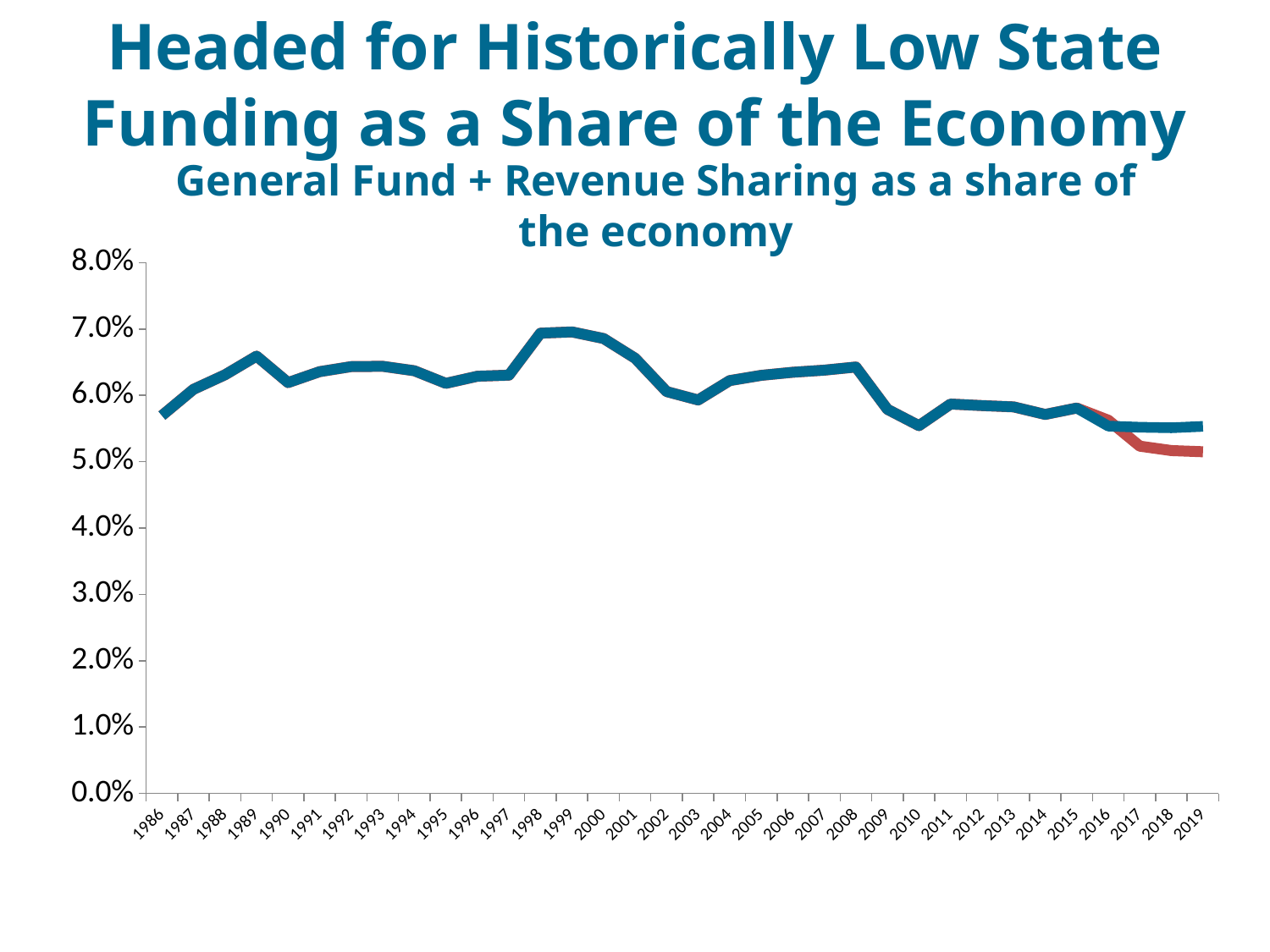
What is the highest tick value shown on the y axis? 8.0% Is the value of the red line for 2019 greater or less than 6.0%? less How many years are labelled along the x axis of the chart? 34 Which year has the larger value, 2008 or 2009? 2008 What is the first year shown on the x axis? 1986 Is the value for 1986 greater or less than 6.0%? less Is the value for 1999 greater or less than 6.0%? greater In 2019, which line shows the larger value, the blue line or the red line? the blue line What kind of chart is shown on the slide? line chart Which year has the larger value, 1999 or 2010? 1999 Do the values rise or fall from 2008 to 2010? fall